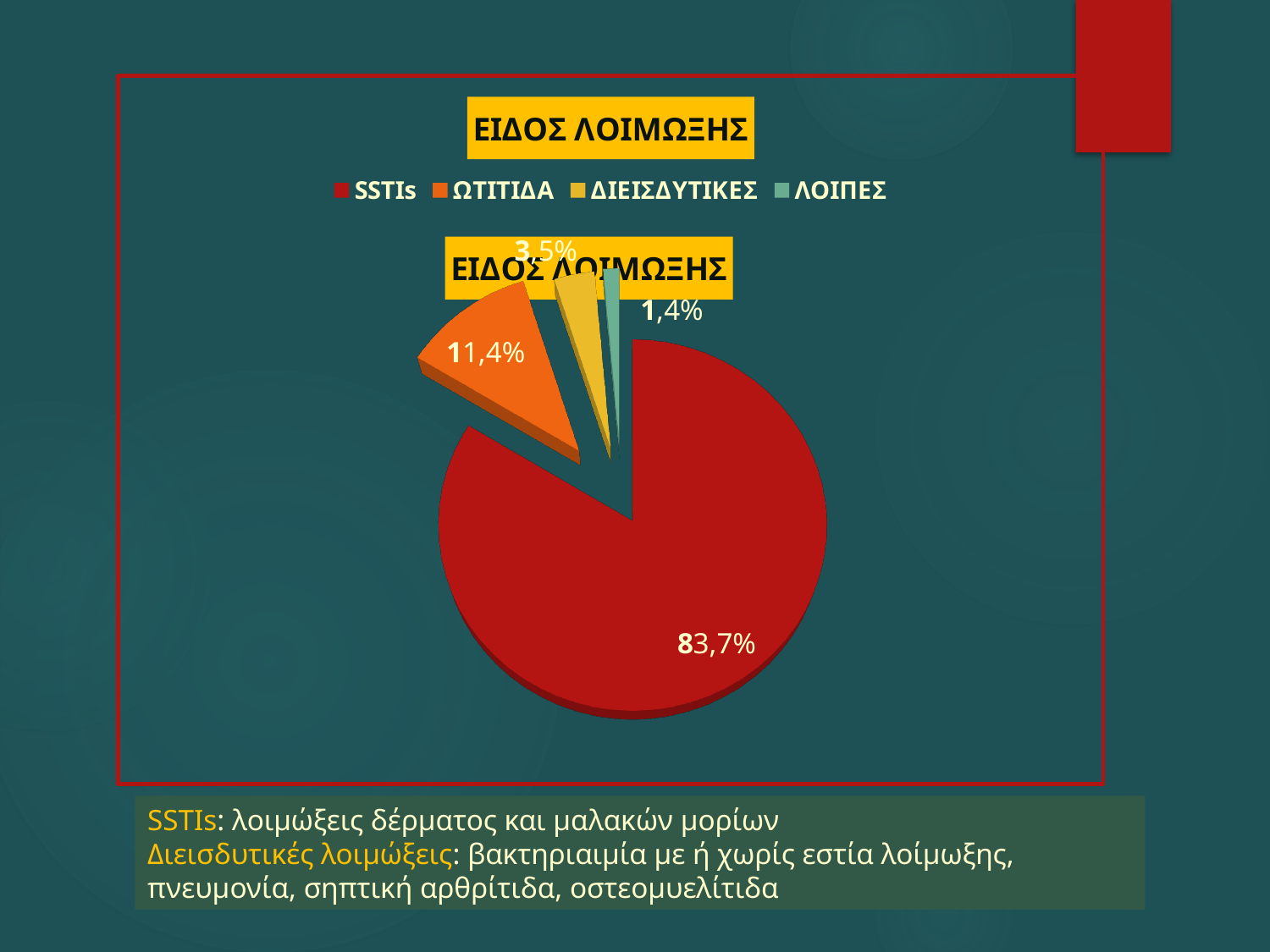
What percentage of the pie is ΛΟΙΠΕΣ? 1,4% Which category has the largest share of the pie? SSTIs How many categories does the legend list? 4 What percentage of the pie is ΩΤΙΤΙΔΑ? 11,4% What is the title of the chart? ΕΙΔΟΣ ΛΟΙΜΩΞΗΣ What kind of chart is shown on the slide? Pie chart What percentage of the pie is SSTIs? 83,7% What colour is the SSTIs slice? Red What is the difference in percentage points between SSTIs and ΩΤΙΤΙΔΑ? 72,3 Which is larger, the share for ΩΤΙΤΙΔΑ or the share for ΔΙΕΙΣΔΥΤΙΚΕΣ? ΩΤΙΤΙΔΑ What percentage of the pie is ΔΙΕΙΣΔΥΤΙΚΕΣ? 3,5% Which category has the smallest share of the pie? ΛΟΙΠΕΣ